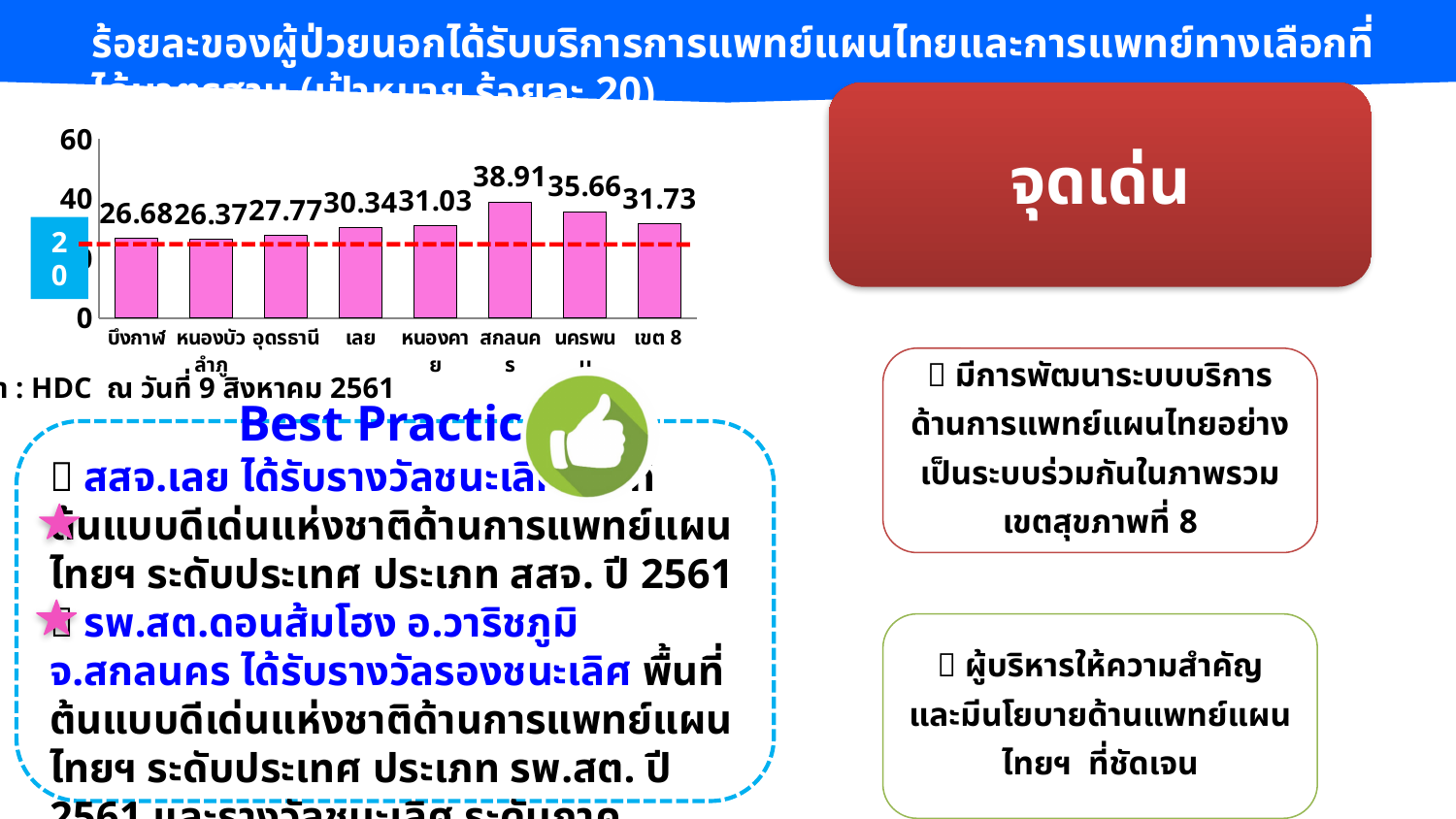
Which province has the lowest value? หนองบัวลำภู What value does the red dashed line on the chart mark? 20 What is the value for เลย? 30.34 Is the value for นครพนม greater or less than 20? greater What is the value for สกลนคร? 38.91 What is the value for บึงกาฬ? 26.68 What is the value for เขต 8? 31.73 How many bars are shown in the chart? 8 What kind of chart is shown on the slide? bar chart Which is larger, the value for หนองคาย or the value for อุดรธานี? หนองคาย Which province has the highest value? สกลนคร What is the difference between the values for สกลนคร and นครพนม? 3.25